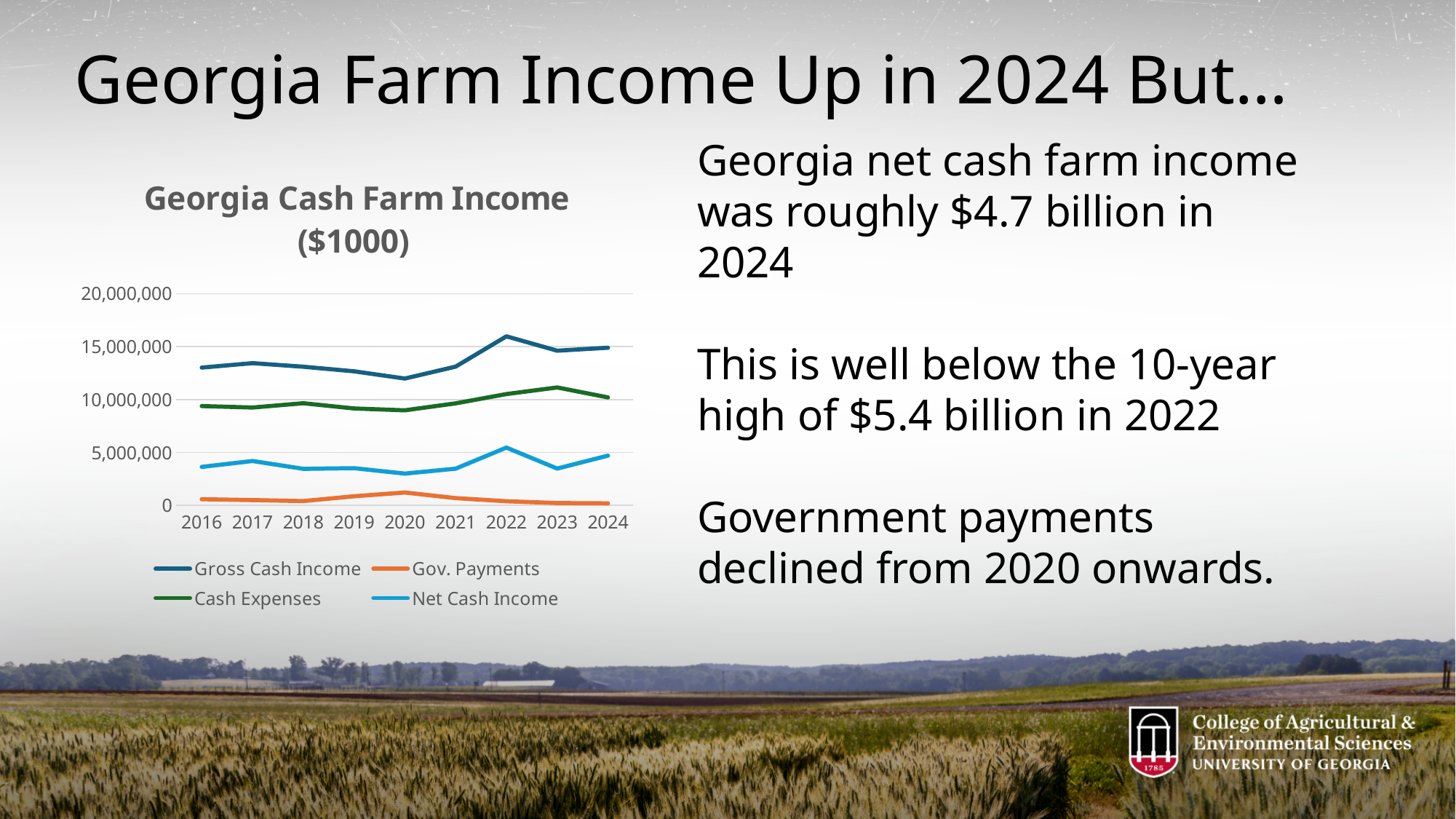
Is the Cash Expenses value for 2020 greater or less than 10,000,000? less Is the Net Cash Income value for 2022 greater or less than 5,000,000? greater How many series does the legend of the Georgia Cash Farm Income chart list? 4 What kind of chart is shown on the slide? line chart Does the Gov. Payments line rise or fall from 2020 to 2024? fall Which series is higher in 2024, Cash Expenses or Net Cash Income? Cash Expenses Is the Gross Cash Income value for 2022 greater or less than 15,000,000? greater How many years are plotted along the x axis of the chart? 9 In which year is Gross Cash Income at its lowest? 2020 In which year does the Gross Cash Income line reach its highest point? 2022 In which year does the Gov. Payments line reach its highest point? 2020 What is the title of the chart? Georgia Cash Farm Income ($1000)